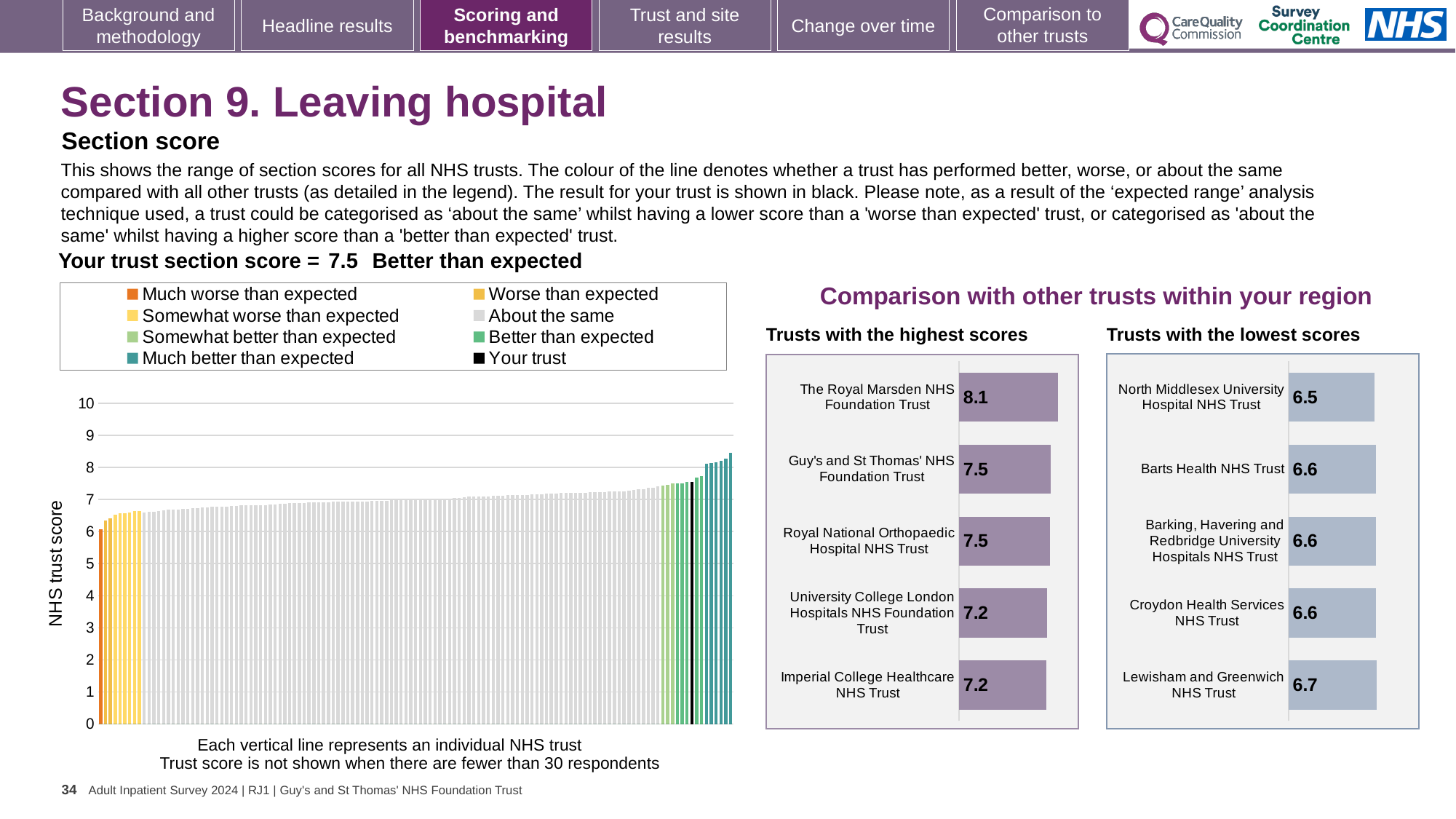
In the 'Trusts with the lowest scores' chart, what is the difference between the scores of Lewisham and Greenwich NHS Trust and North Middlesex University Hospital NHS Trust? 0.2 What kind of chart is the large 'NHS trust score' chart on the left? bar chart In the 'Trusts with the highest scores' chart, which trust has the highest score? The Royal Marsden NHS Foundation Trust In the large 'NHS trust score' chart on the left, do the values rise or fall from left to right? rise In the large 'NHS trust score' chart, what is the section score for your trust (the black bar)? 7.5 In the 'Trusts with the highest scores' chart, what is the difference between the scores of The Royal Marsden NHS Foundation Trust and Imperial College Healthcare NHS Trust? 0.9 In the 'Trusts with the lowest scores' chart, what is the score for Lewisham and Greenwich NHS Trust? 6.7 In the 'Trusts with the lowest scores' chart, which trust has the lowest score? North Middlesex University Hospital NHS Trust How many trusts are shown in the 'Trusts with the highest scores' chart? 5 How many entries does the legend of the large 'NHS trust score' chart list? 8 In the 'Trusts with the lowest scores' chart, which has the larger score: Barts Health NHS Trust or Lewisham and Greenwich NHS Trust? Lewisham and Greenwich NHS Trust In the 'Trusts with the highest scores' chart, what is the score for The Royal Marsden NHS Foundation Trust? 8.1